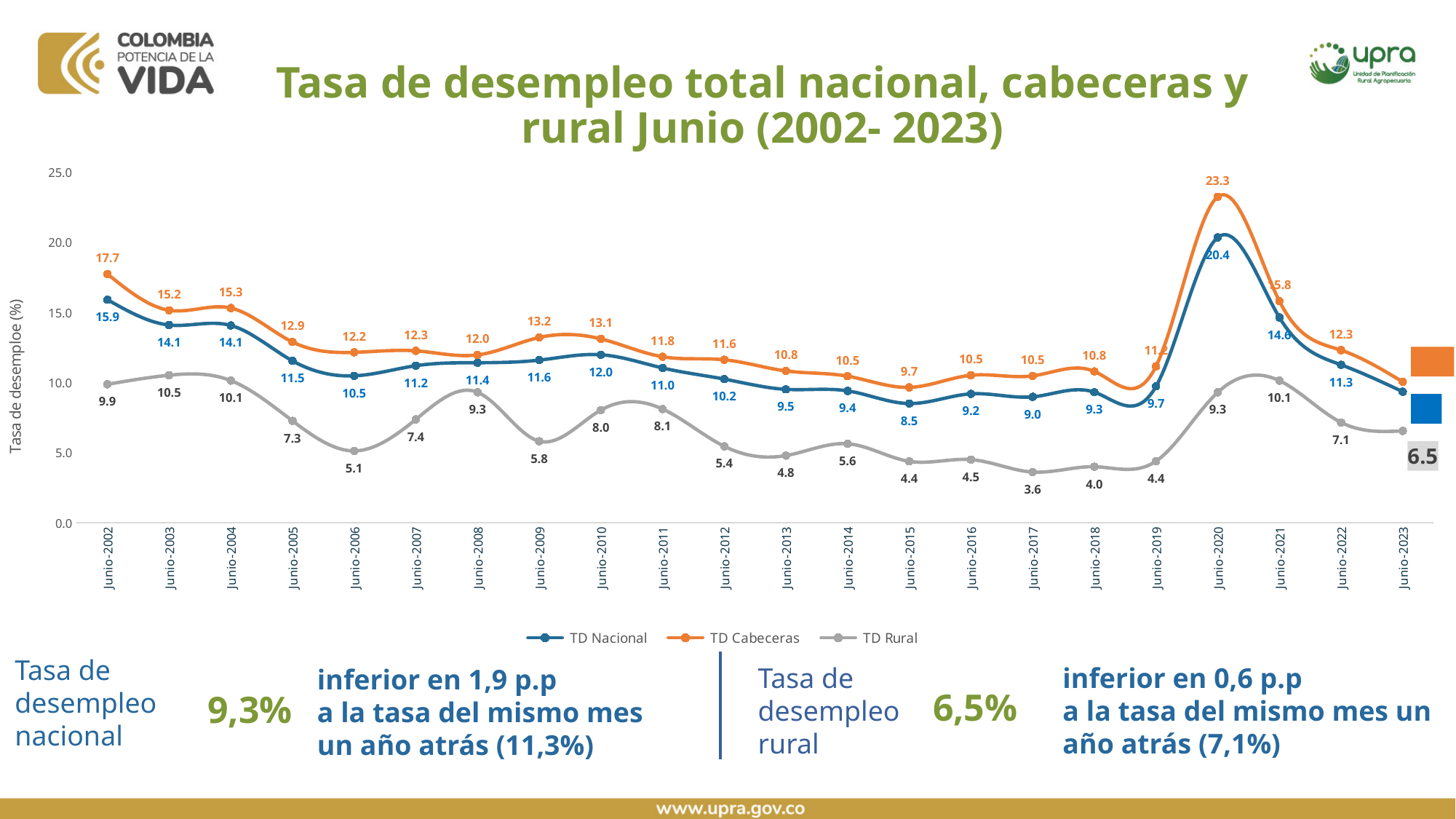
How many periods are plotted along the x axis? 22 What kind of chart is shown on the slide? Line chart In which period does TD Nacional reach its highest value? Junio-2020 What is the TD Cabeceras value for Junio-2020? 23.3 How many series does the legend list? 3 What is the difference between the TD Nacional values for Junio-2020 and Junio-2019? 10.7 What is the TD Rural value for Junio-2006? 5.1 Which is larger, the TD Nacional value for Junio-2002 or for Junio-2003? Junio-2002 Does TD Rural rise or fall from Junio-2003 to Junio-2006? Fall In which period does TD Rural reach its lowest value? Junio-2017 What is the TD Nacional value for Junio-2015? 8.5 Is the TD Cabeceras value for Junio-2020 greater or less than 20.0? greater